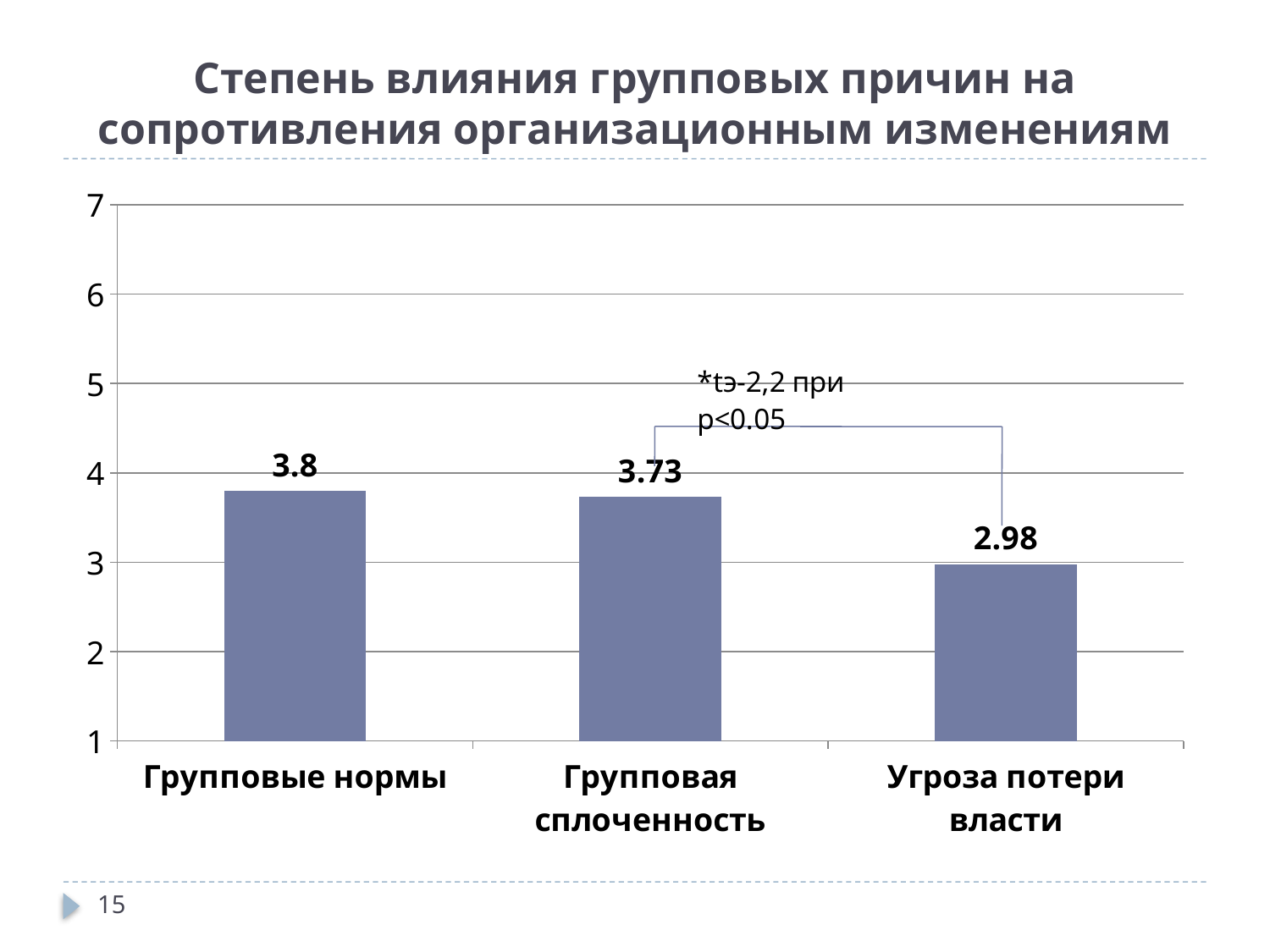
Is the value for Угроза потери власти greater or less than 3? less What is the difference between the values for Групповые нормы and Угроза потери власти? 0.82 What is the value for Угроза потери власти? 2.98 How many categories are shown on the chart? 3 What is the value for Групповые нормы? 3.8 Which category has the lowest value? Угроза потери власти Is the value for Групповые нормы greater or less than 4? less What kind of chart is shown on the slide? bar chart Do the values rise or fall from left to right across the categories? fall What is the difference between the values for Групповая сплоченность and Угроза потери власти? 0.75 Which is larger, the value for Групповая сплоченность or the value for Угроза потери власти? Групповая сплоченность What is the value for Групповая сплоченность? 3.73